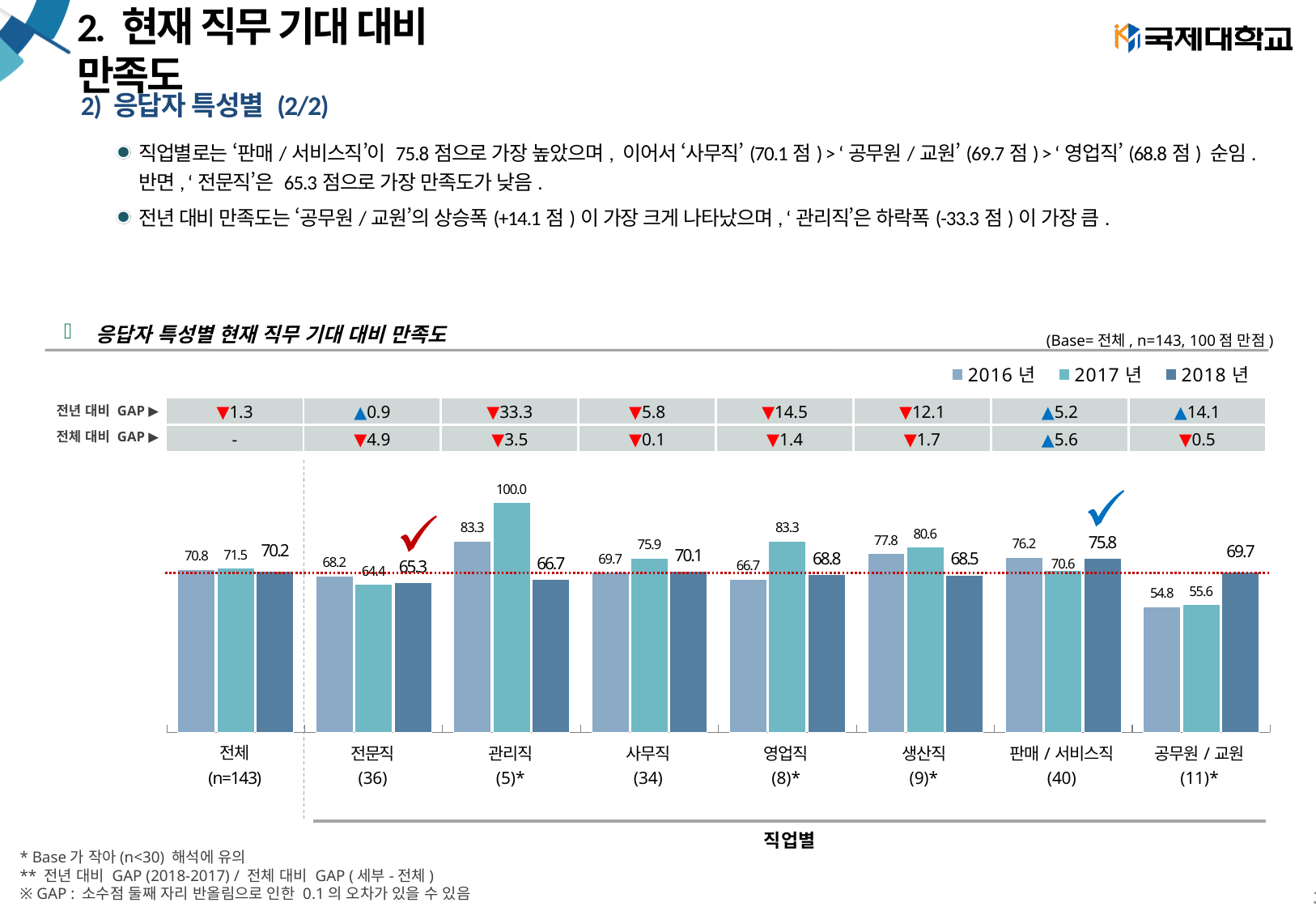
Which is larger for 생산직: the 2016년 value or the 2018년 value? 2016년 What is the 전년 대비 GAP shown for 관리직? ▼33.3 What is the 2016년 value for 공무원 / 교원? 54.8 How many categories are shown on the x axis of the chart? 8 What is the difference between the 2017년 and 2018년 values for 관리직? 33.3 What is the difference between the 2018년 and 2017년 values for 공무원 / 교원? 14.1 What kind of chart is shown on the slide? bar chart Which category has the highest 2017년 value? 관리직 What is the 2018년 value for 판매 / 서비스직? 75.8 How many series does the legend list? 3 What is the 2017년 value for 관리직? 100.0 Which category has the lowest 2018년 value? 전문직